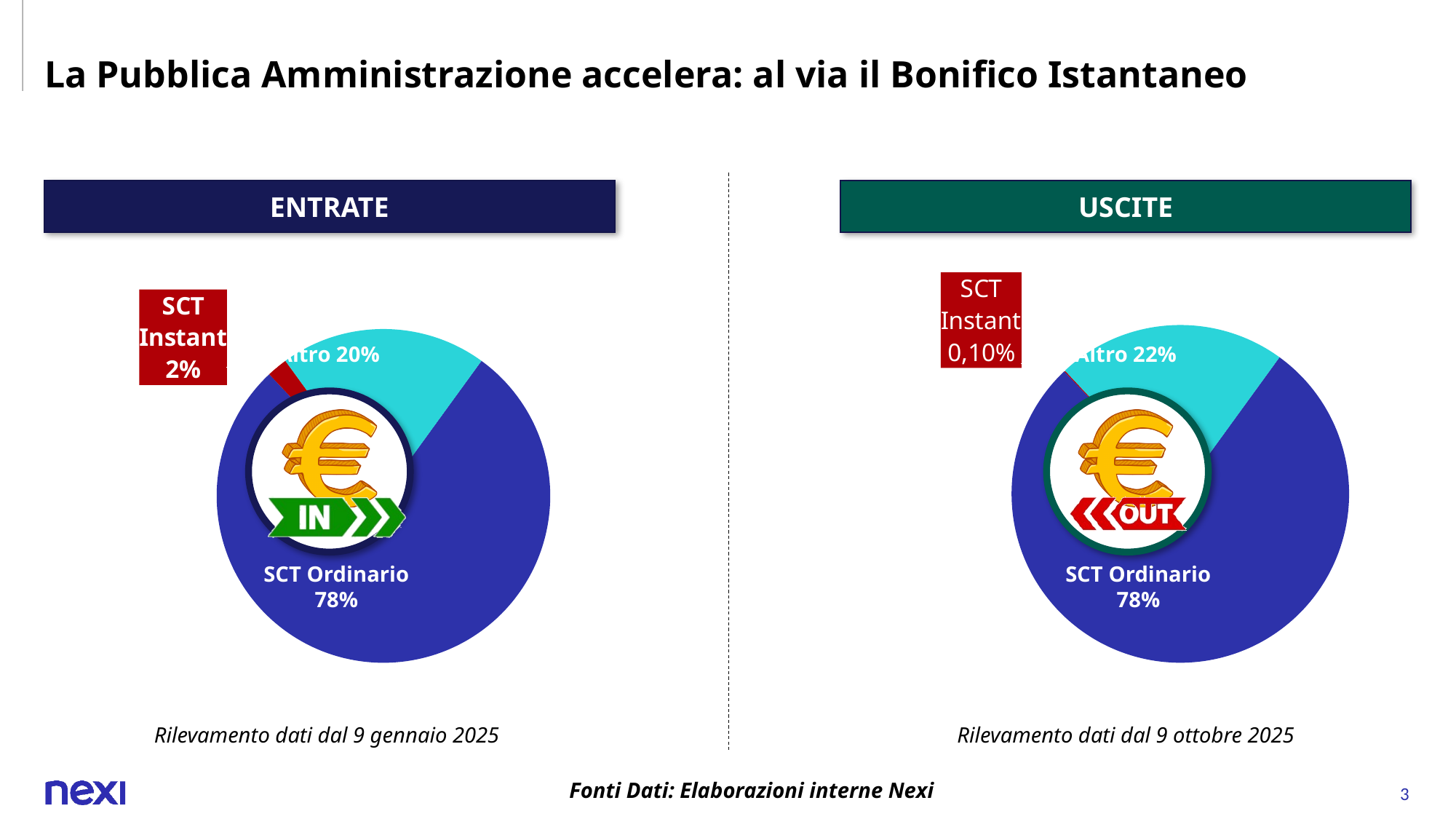
In the USCITE chart, what share does SCT Instant have? 0,10% In the USCITE chart, what share does Altro have? 22% How many slices does the USCITE pie chart have? 3 In the ENTRATE chart, what share does Altro have? 20% What type of chart is used for ENTRATE? Pie chart Which is larger: the SCT Instant share in the ENTRATE chart or the SCT Instant share in the USCITE chart? ENTRATE In the ENTRATE chart, what share does SCT Ordinario have? 78% What colour is the SCT Instant slice in the ENTRATE chart? Red In the ENTRATE chart, what share does SCT Instant have? 2% In the USCITE chart, which category has the largest slice? SCT Ordinario In the ENTRATE chart, which category has the smallest slice? SCT Instant In the ENTRATE chart, what is the difference between the SCT Ordinario share and the Altro share? 58%